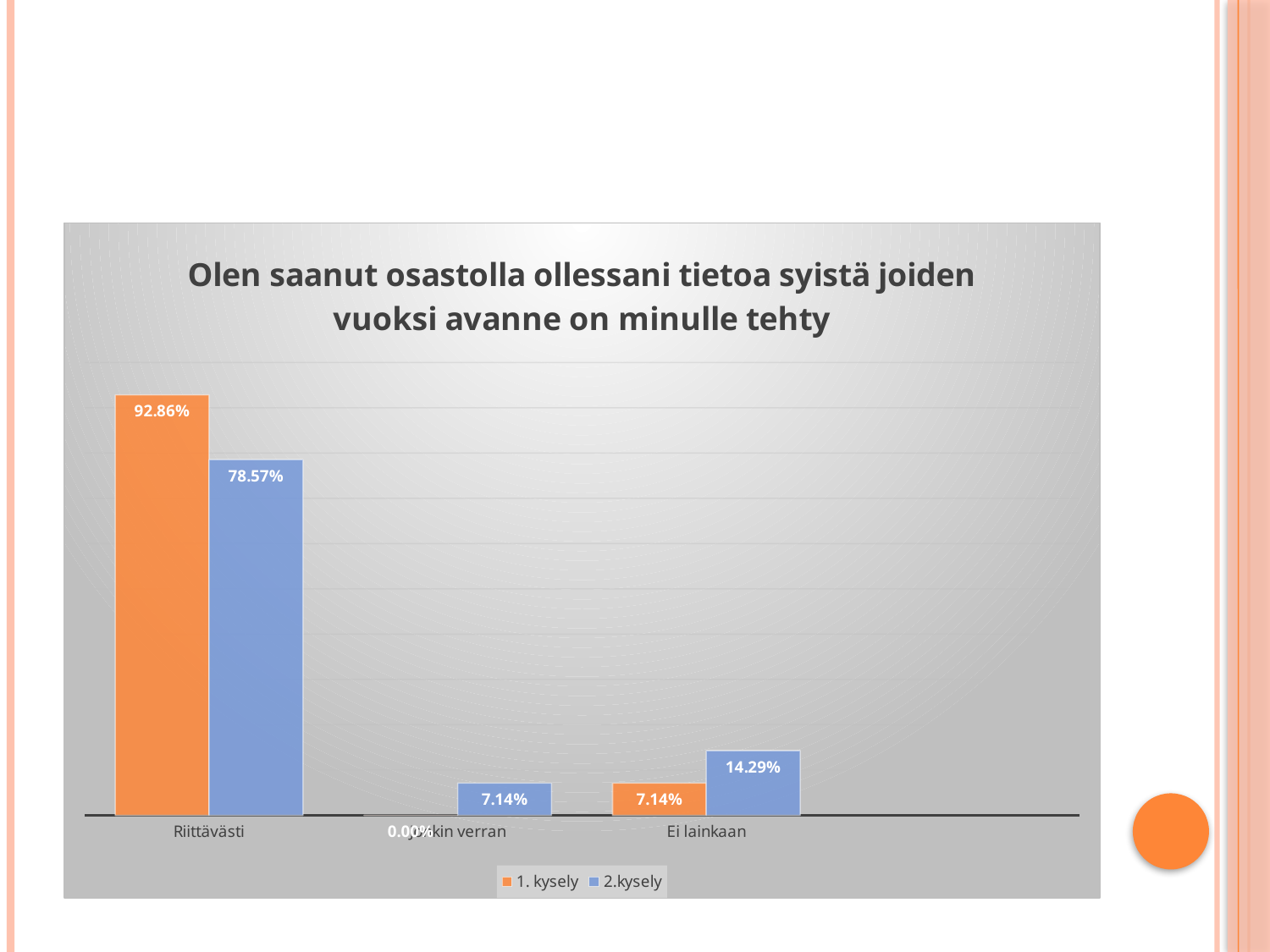
Which category has the lowest value in the 2.kysely series? The middle category (Jonkin verran) What is the value for Riittävästi in the 2.kysely series? 78.57% What is the value for Ei lainkaan in the 1. kysely series? 7.14% What is the value for Riittävästi in the 1. kysely series? 92.86% Which category has the highest value in the 1. kysely series? Riittävästi How many series does the legend list? 2 What is the value for Ei lainkaan in the 2.kysely series? 14.29% What kind of chart is shown on the slide? Bar chart What is the difference between the 1. kysely and 2.kysely values for Riittävästi? 14.29% For Ei lainkaan, which series has the larger value, 1. kysely or 2.kysely? 2.kysely What is the 2.kysely value for the middle category on the x axis? 7.14% How many categories are shown on the x axis? 3